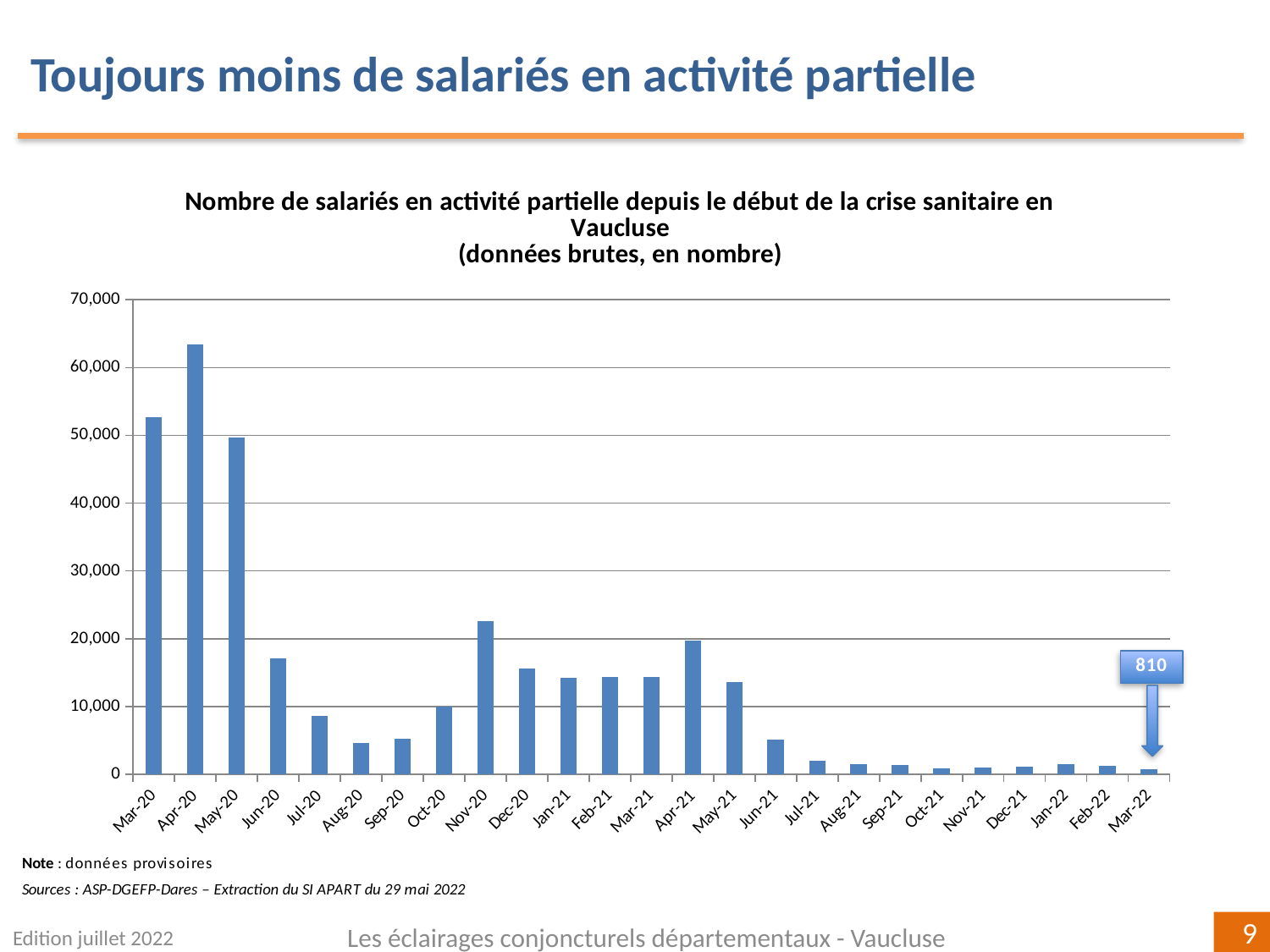
Is the value for Mar-20 greater or less than 50,000? greater What is the title of the chart? Nombre de salariés en activité partielle depuis le début de la crise sanitaire en Vaucluse (données brutes, en nombre) Which month has the highest number of salariés en activité partielle? Apr-20 Is the value for Jun-20 greater or less than 10,000? greater How many months are plotted on the x axis? 25 Is the value for Jul-20 greater or less than 10,000? less What is the value for Mar-22? 810 Overall, do the values rise or fall from Mar-20 to Mar-22? fall What type of chart is shown on the slide? bar chart Which is larger, the value for Nov-20 or the value for Dec-20? Nov-20